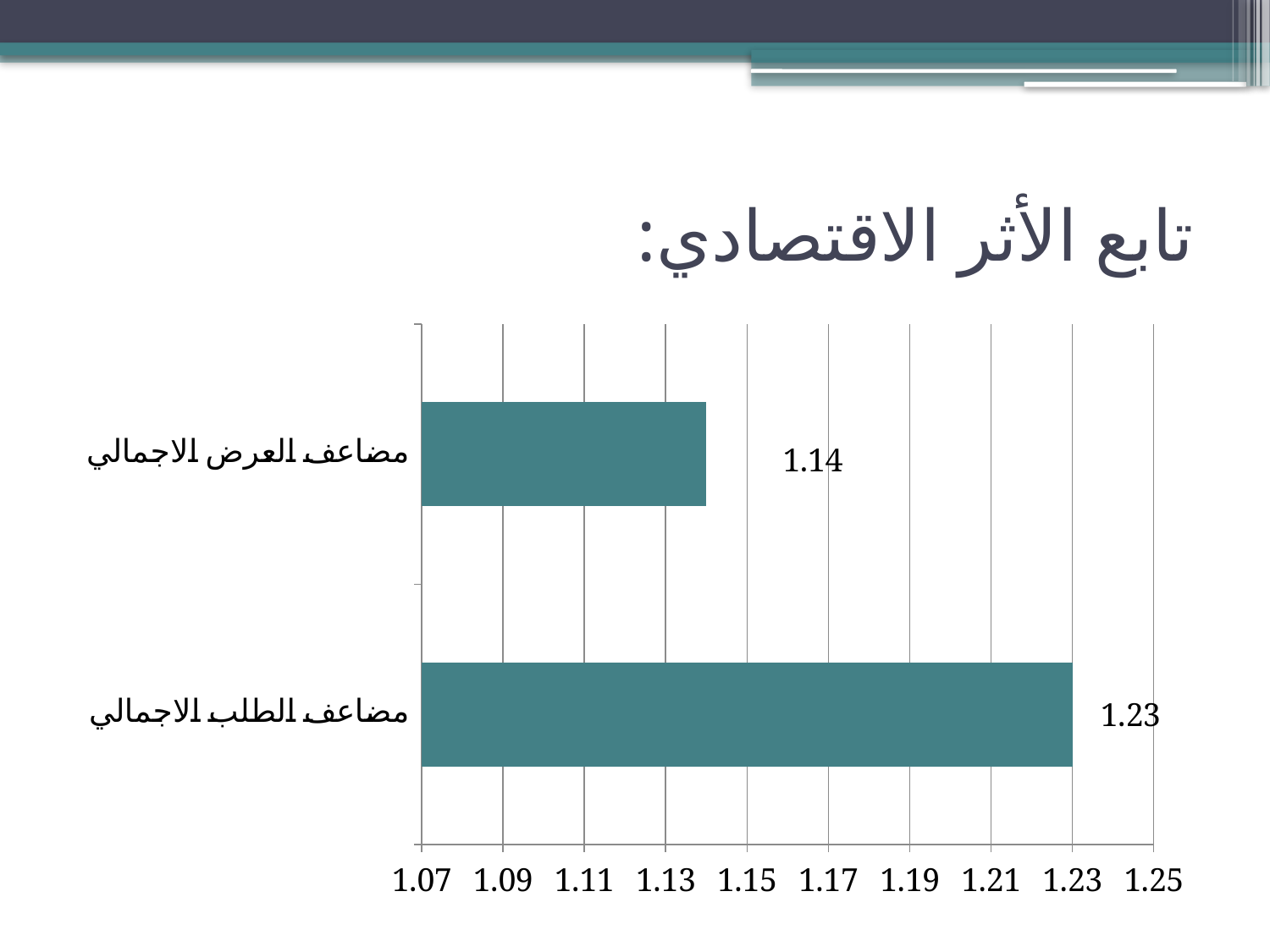
What kind of chart is shown on the slide? bar chart Which category has the highest value? مضاعف الطلب الاجمالي How many categories are shown in the chart? 2 Which is larger, the value for مضاعف العرض الاجمالي or the value for مضاعف الطلب الاجمالي? مضاعف الطلب الاجمالي What is the value for مضاعف العرض الاجمالي? 1.14 Is the value for مضاعف العرض الاجمالي greater or less than 1.15? less Which category has the lowest value? مضاعف العرض الاجمالي What is the value for مضاعف الطلب الاجمالي? 1.23 What is the highest value shown on the horizontal axis? 1.25 Is the value for مضاعف الطلب الاجمالي greater or less than 1.21? greater What is the difference between the values for مضاعف الطلب الاجمالي and مضاعف العرض الاجمالي? 0.09 What is the title of the slide? تابع الأثر الاقتصادي: